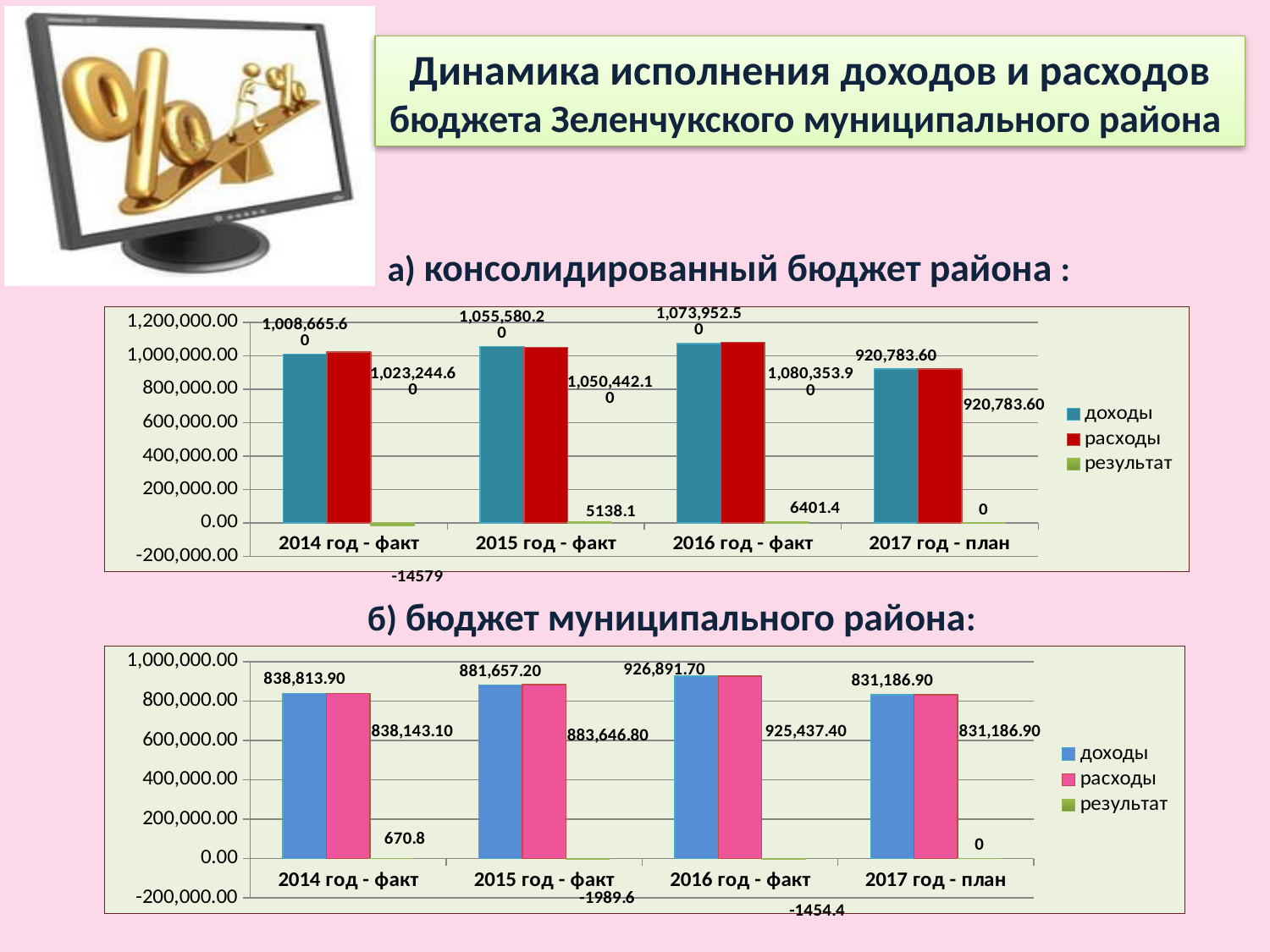
In the chart 'б) бюджет муниципального района', how many categories are shown on the x axis? 4 In the chart 'а) консолидированный бюджет района', what is the difference between результат for 2016 год - факт and 2015 год - факт? 1263.3 What type of chart is 'б) бюджет муниципального района'? bar chart In the chart 'а) консолидированный бюджет района', how many series does the legend list? 3 In the chart 'а) консолидированный бюджет района', what is the value of результат for 2014 год - факт? -14579 In the chart 'а) консолидированный бюджет района', what is the value of доходы for 2016 год - факт? 1,073,952.50 In the chart 'а) консолидированный бюджет района', which category has the highest расходы value? 2016 год - факт In the chart 'б) бюджет муниципального района', what is the difference between доходы for 2016 год - факт and 2014 год - факт? 88,077.80 In the chart 'б) бюджет муниципального района', what is the value of расходы for 2015 год - факт? 883,646.80 In the chart 'а) консолидированный бюджет района', which category has the lowest доходы value? 2017 год - план In the chart 'б) бюджет муниципального района', which category has the highest доходы value? 2016 год - факт In the chart 'б) бюджет муниципального района', what is the value of результат for 2016 год - факт? -1454.4